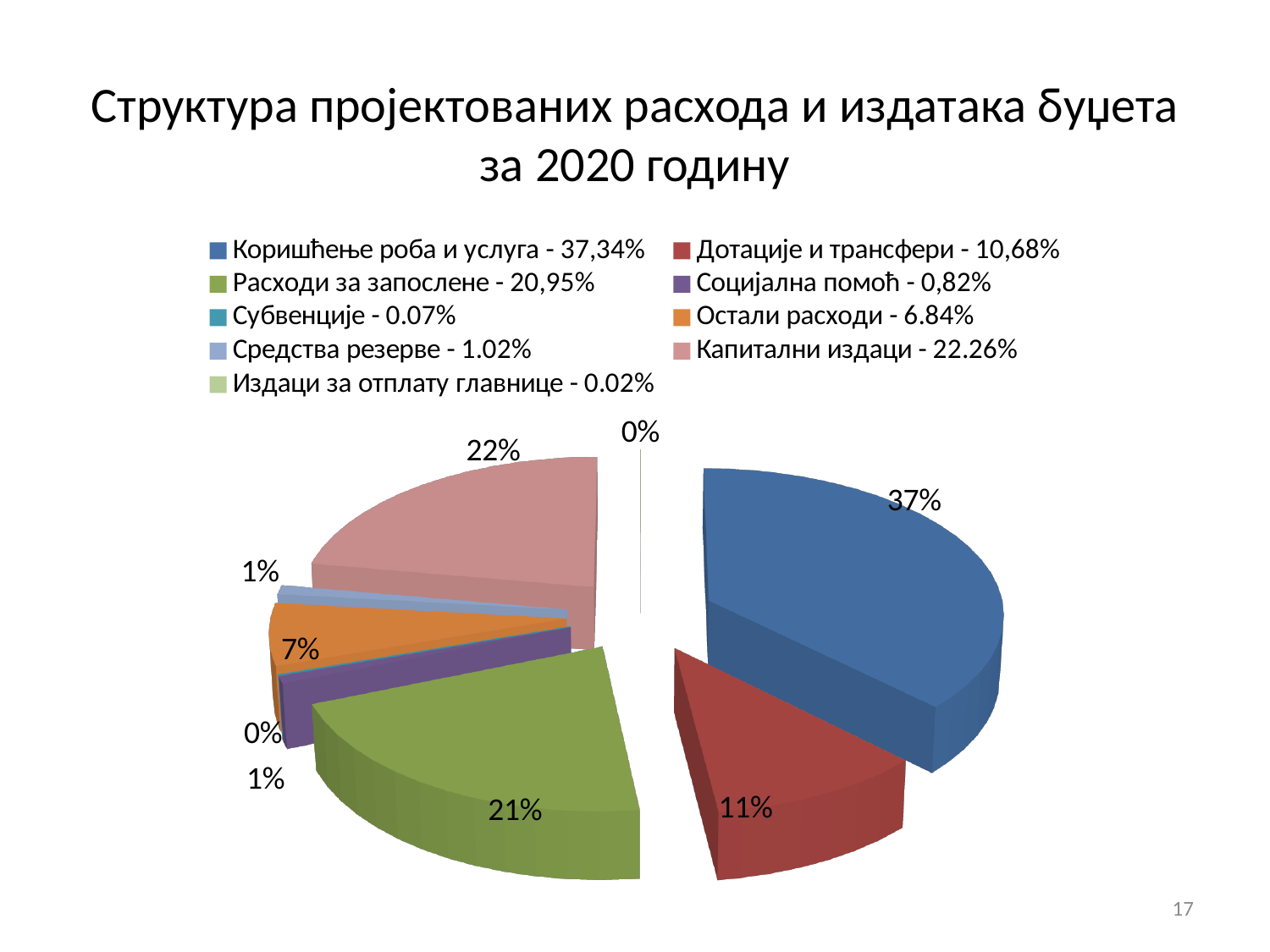
What exact value does the legend give for Средства резерве? 1.02% What is the difference in percentage points between the Коришћење роба и услуга slice (37%) and the Дотације и трансфери slice (11%)? 26% What percentage is shown on the pie slice for Капитални издаци? 22% What kind of chart is shown on the slide? pie chart How many slices (categories) does the pie chart have? 9 What share of the pie does Расходи за запослене have? 21% Which category has the largest share of the pie? Коришћење роба и услуга What is the title of the chart slide? Структура пројектованих расхода и издатака буџета за 2020 годину What share of the pie does Остали расходи have? 7% Which category has the smallest share according to the legend? Издаци за отплату главнице What percentage is shown on the pie slice for Дотације и трансфери? 11% Which is larger, the share for Расходи за запослене or the share for Капитални издаци? Капитални издаци